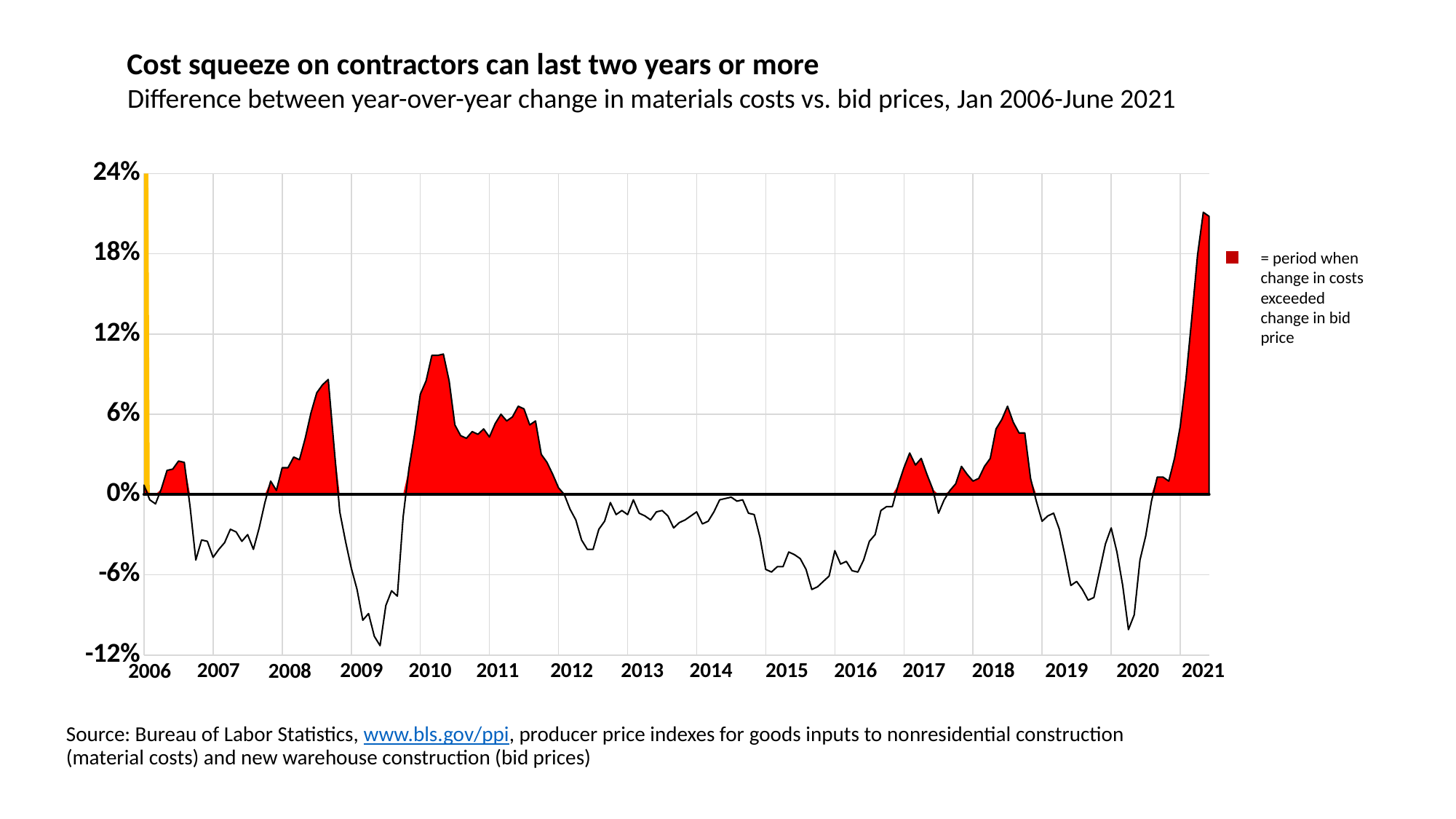
Is the lowest value reached in 2009 greater or less than -6%? less Is the peak value reached in 2021 greater or less than 18%? greater What is the title of the chart? Cost squeeze on contractors can last two years or more Is the value at the start of 2015 greater or less than 0%? less In which year does the line reach its lowest value? 2009 In which year does the line reach its highest value? 2021 What kind of chart is shown on the slide? line chart Does the line rise or fall from 2020 to mid-2021? rise According to the legend, what do the red shaded areas represent? period when change in costs exceeded change in bid price Which is larger, the peak value in 2021 or the peak value in 2010? 2021